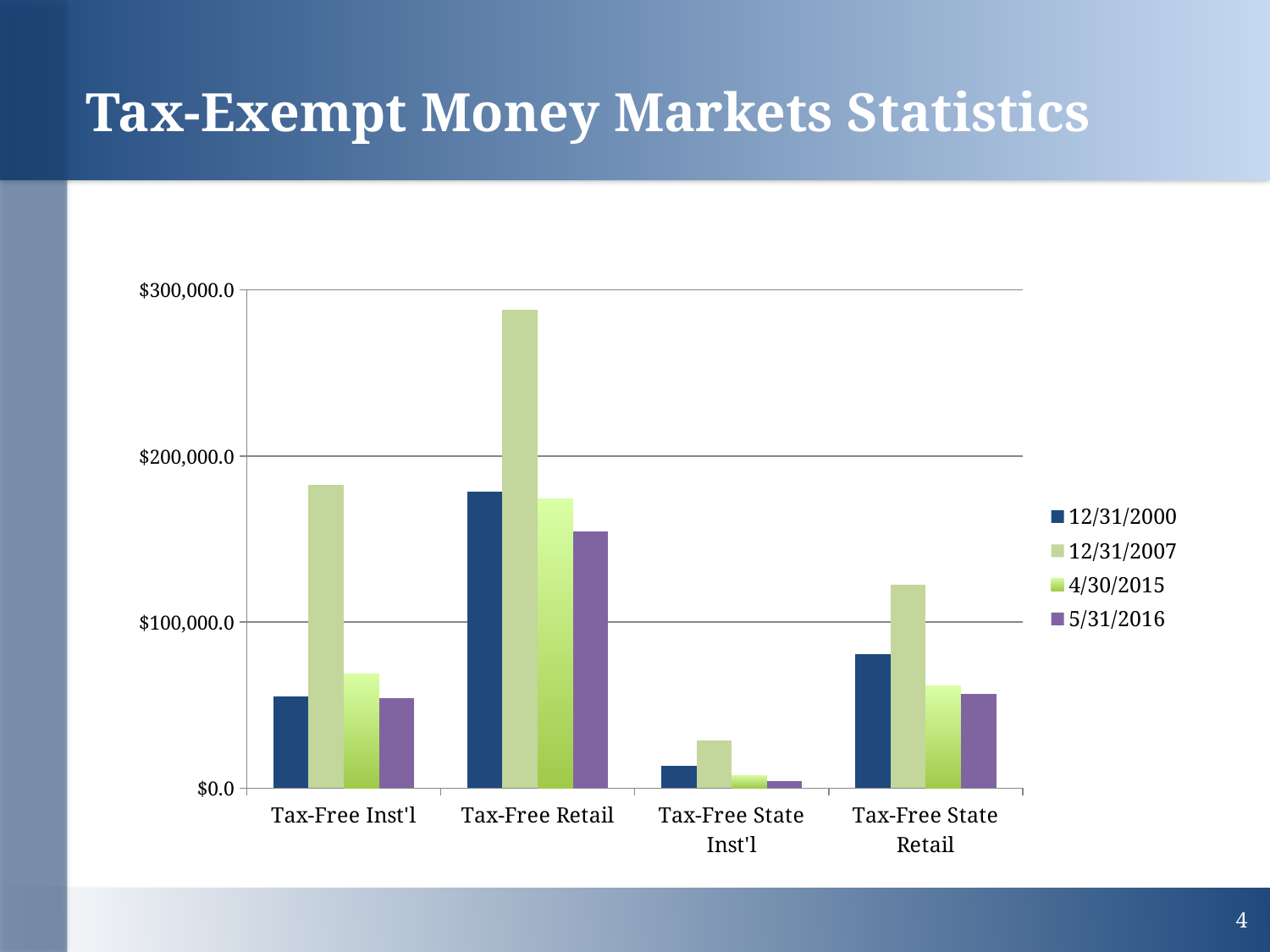
For Tax-Free Retail, which is larger: the 12/31/2000 value or the 5/31/2016 value? 12/31/2000 Is the 12/31/2000 value for Tax-Free State Retail greater or less than $100,000.0? less What kind of chart is shown on the slide? Bar chart How many categories are shown on the x axis? 4 Which category has the lowest 12/31/2007 bar? Tax-Free State Inst'l What is the first entry listed in the legend? 12/31/2000 Which category has the highest 12/31/2007 bar? Tax-Free Retail Is the 12/31/2007 value for Tax-Free Inst'l greater or less than $200,000.0? less For Tax-Free Inst'l, which is larger: the 12/31/2007 value or the 4/30/2015 value? 12/31/2007 Is the 12/31/2007 value for Tax-Free State Retail greater or less than $100,000.0? greater How many series does the legend list? 4